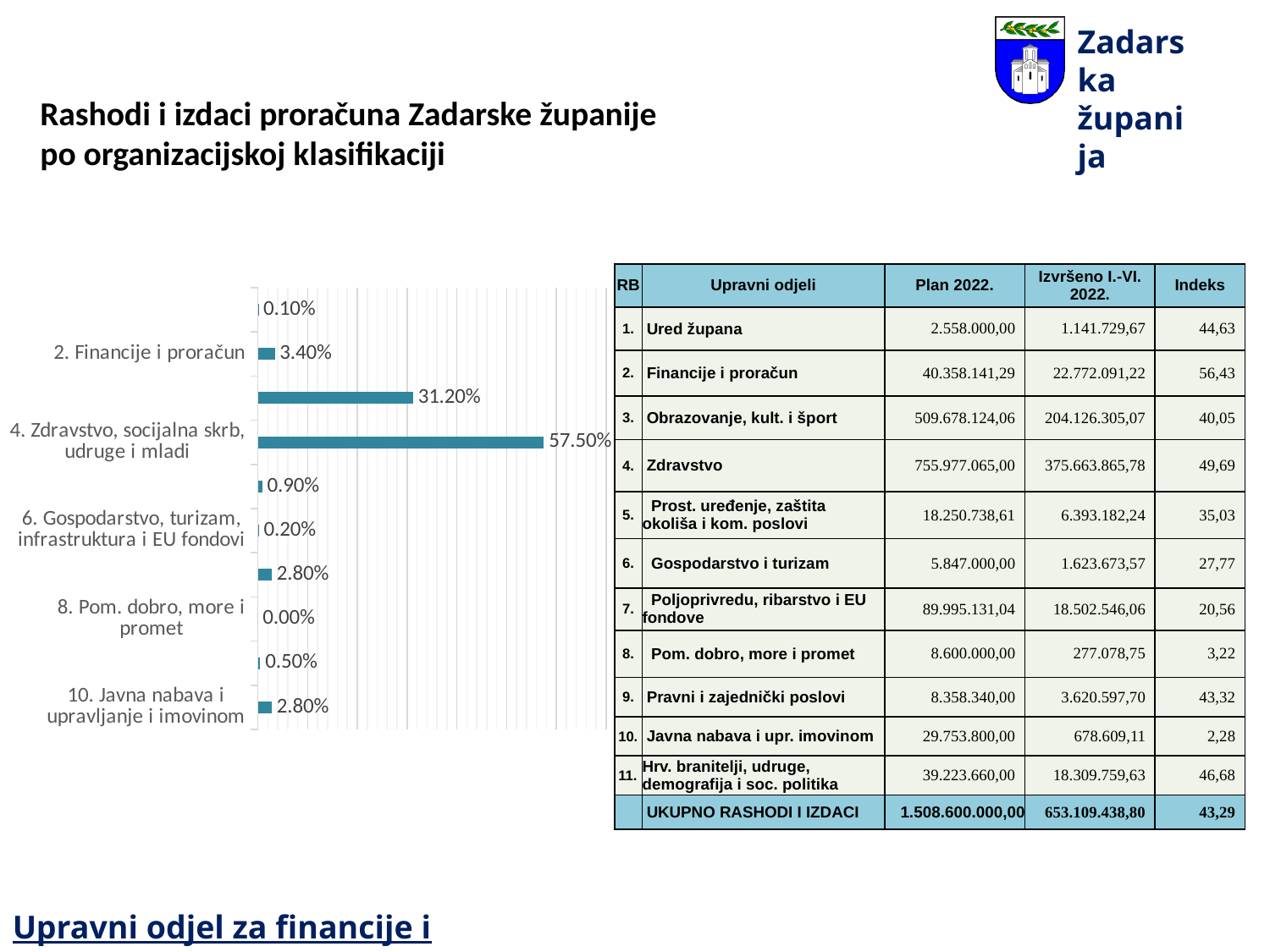
What value does the bar chart show for "8. Pom. dobro, more i promet"? 0.00% How many bars are plotted in the bar chart? 10 Which labelled category has the lowest value in the bar chart? 8. Pom. dobro, more i promet What value does the bar chart show for "10. Javna nabava i upravljanje i imovinom"? 2.80% What value does the bar chart show for "2. Financije i proračun"? 3.40% What is the difference between the values for "4. Zdravstvo, socijalna skrb, udruge i mladi" and "2. Financije i proračun" in the bar chart? 54.10% In the bar chart, which is larger: the value for "2. Financije i proračun" or for "10. Javna nabava i upravljanje i imovinom"? 2. Financije i proračun Which category has the highest value in the bar chart? 4. Zdravstvo, socijalna skrb, udruge i mladi What is the highest value shown as a data label in the bar chart? 57.50% What value does the bar chart show for "4. Zdravstvo, socijalna skrb, udruge i mladi"? 57.50% What type of chart is shown on the left of the slide? Bar chart What value does the bar chart show for "6. Gospodarstvo, turizam, infrastruktura i EU fondovi"? 0.20%